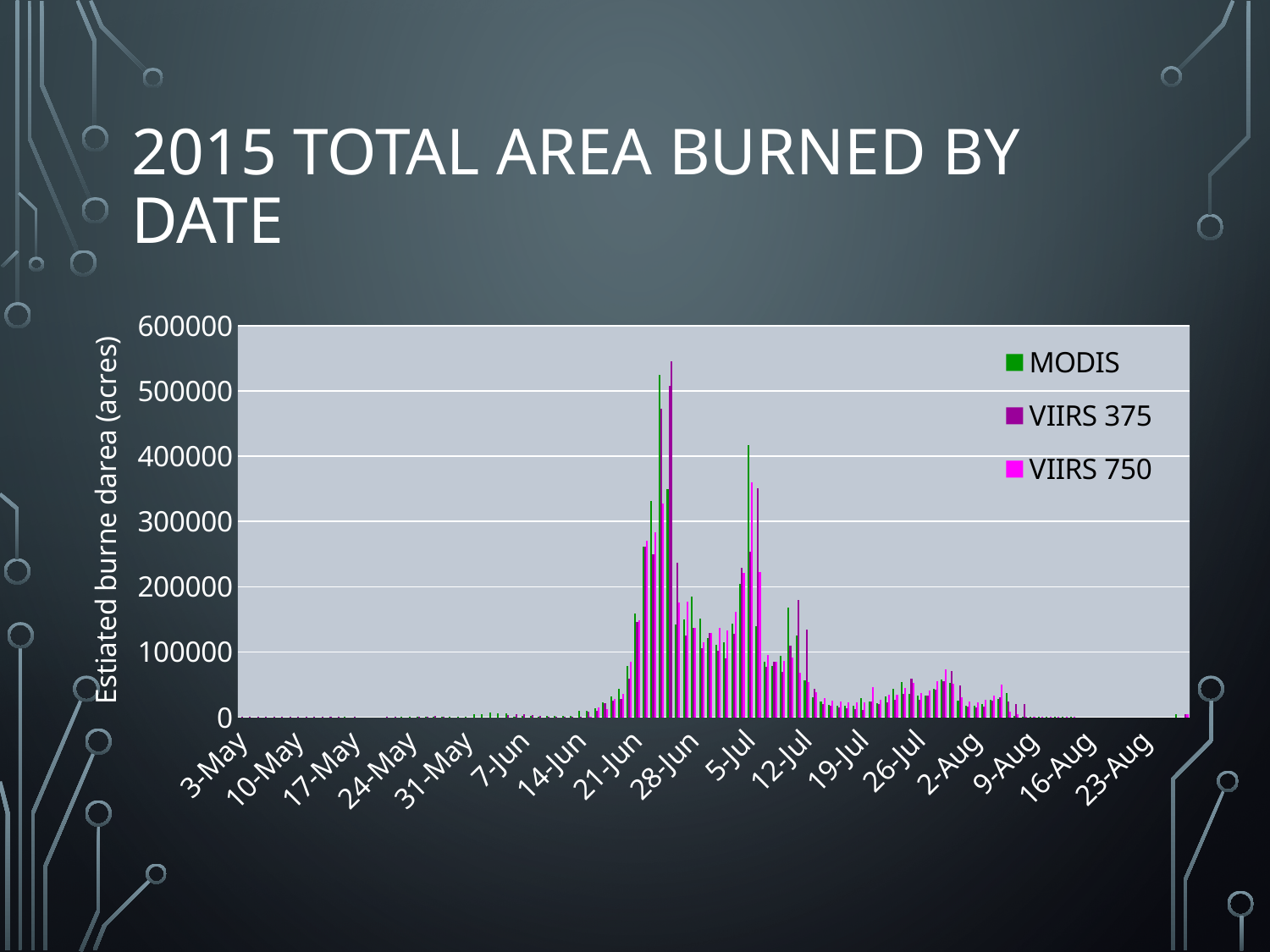
Around which labelled date do the tallest bars occur? 28-Jun Do the values generally rise or fall from 5-Jul to 23-Aug? fall Which peak is larger, the one near 28-Jun or the one near 5-Jul? 28-Jun Are the values around 3-May greater or less than 100000? less Is the tallest MODIS bar greater or less than 400000? greater How many series does the legend list? 3 What is the title of the chart? 2015 TOTAL AREA BURNED BY DATE What is the highest value shown on the y axis? 600000 How many date labels are shown along the x axis? 17 What are the three series named in the legend? MODIS, VIIRS 375, VIIRS 750 What kind of chart is shown on the slide? bar chart